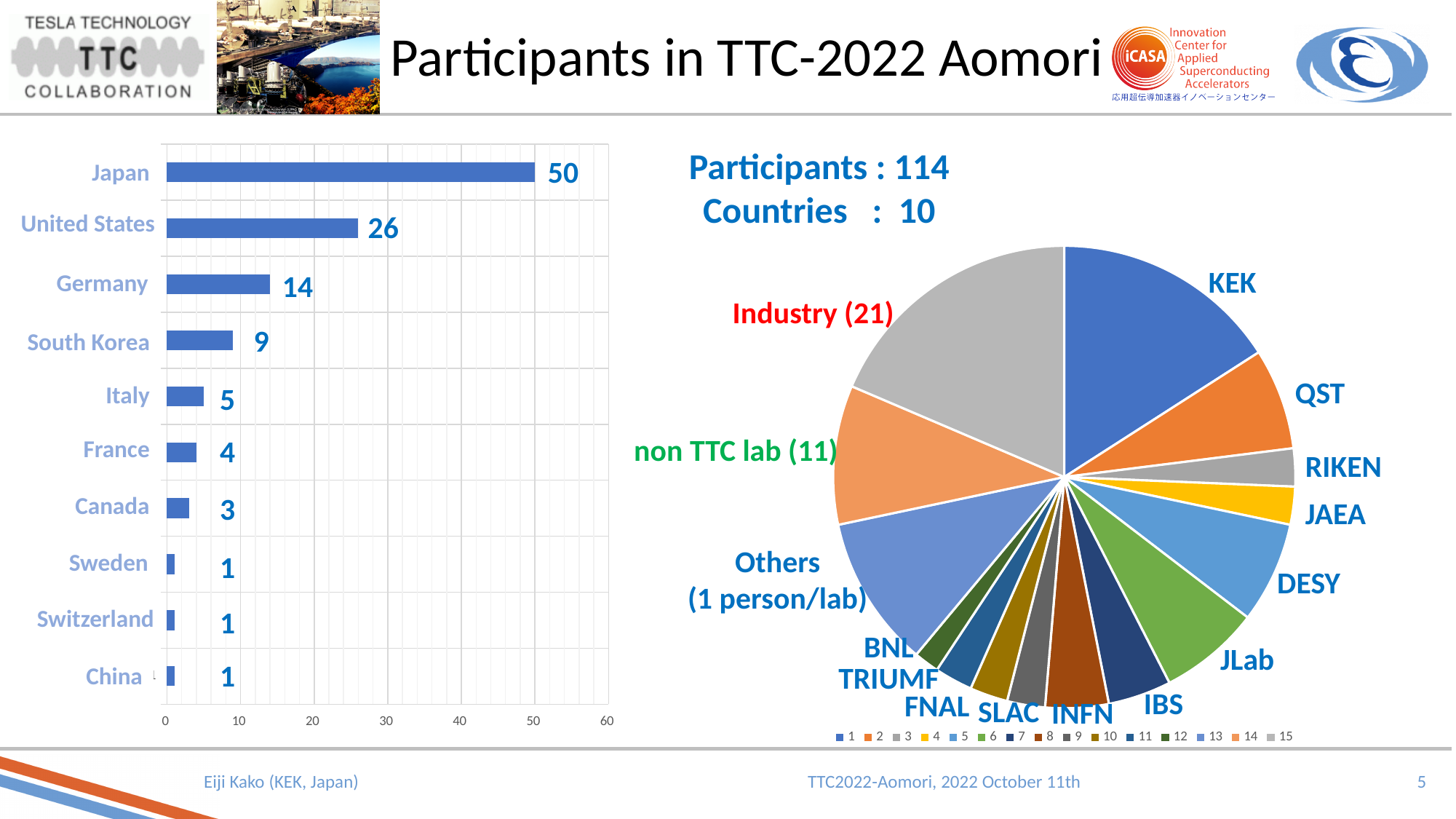
In the bar chart on the left, what is the value for Germany? 14 How many entries does the legend of the pie chart on the right list? 15 How many countries are listed in the bar chart on the left? 10 In the bar chart on the left, what is the difference between the values for Japan and the United States? 24 In the bar chart on the left, is the value for the United States greater or less than 20? greater In the bar chart on the left, how many participants are from Japan? 50 In the pie chart on the right, how many participants are labelled as Industry? 21 In the bar chart on the left, which country has the highest number of participants? Japan What kind of chart is the chart on the left of the slide? bar chart What kind of chart is the chart on the right of the slide? pie chart In the pie chart on the right, how many participants are labelled as non TTC lab? 11 In the bar chart on the left, which has a larger value, Italy or France? Italy